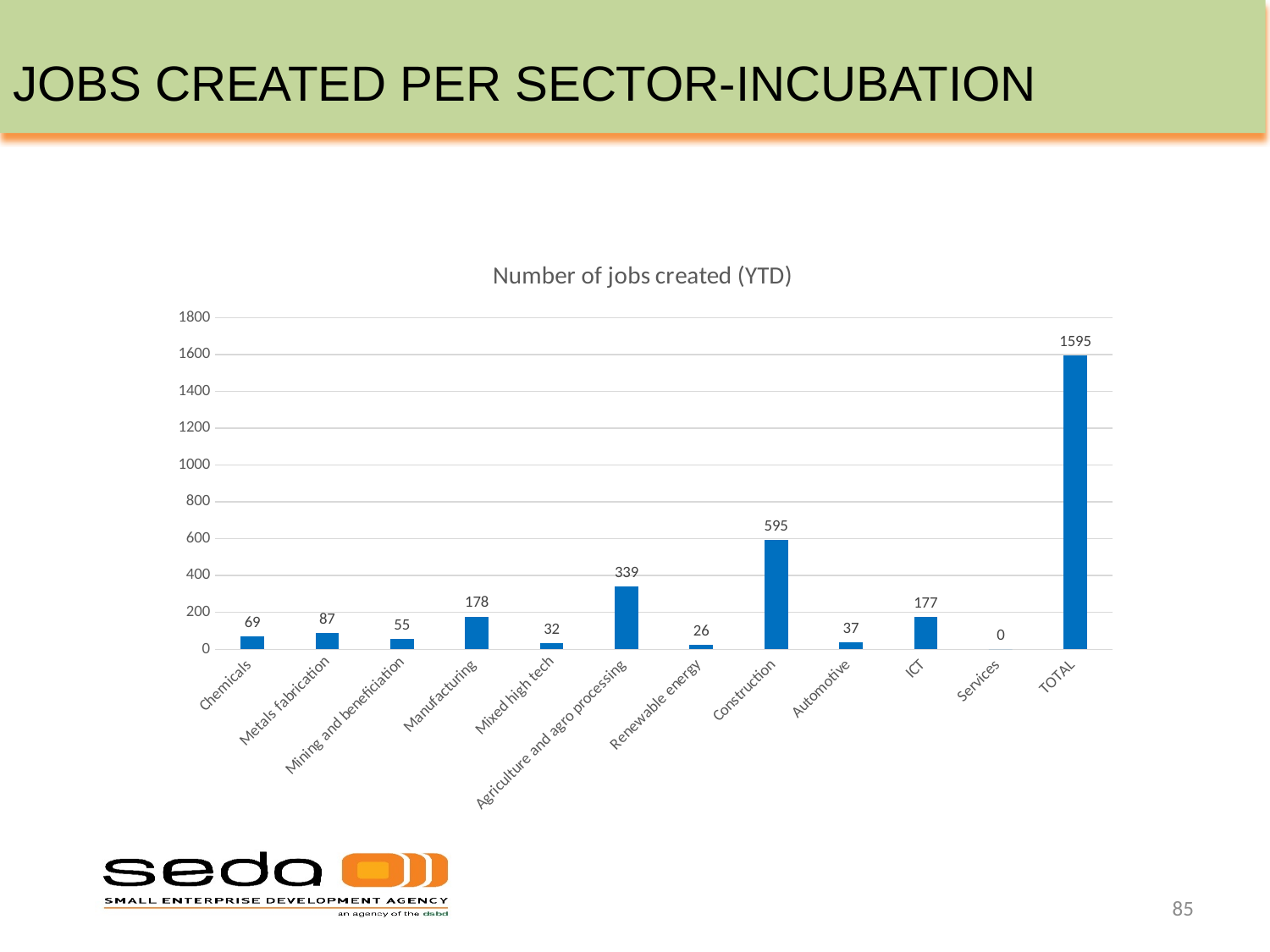
What is the title of the chart? Number of jobs created (YTD) Excluding the TOTAL bar, which sector has the highest number of jobs created? Construction What is the difference between the jobs created for Construction and for Agriculture and agro processing? 256 What is the number of jobs created for Construction? 595 Which has more jobs created, Manufacturing or ICT? Manufacturing What kind of chart is shown on the slide? Bar chart Which sector has the lowest number of jobs created? Services Is the value for Construction greater or less than 400? greater How many categories are shown on the x axis? 12 What is the number of jobs created for Renewable energy? 26 What is the value shown for TOTAL? 1595 What is the number of jobs created for Agriculture and agro processing? 339